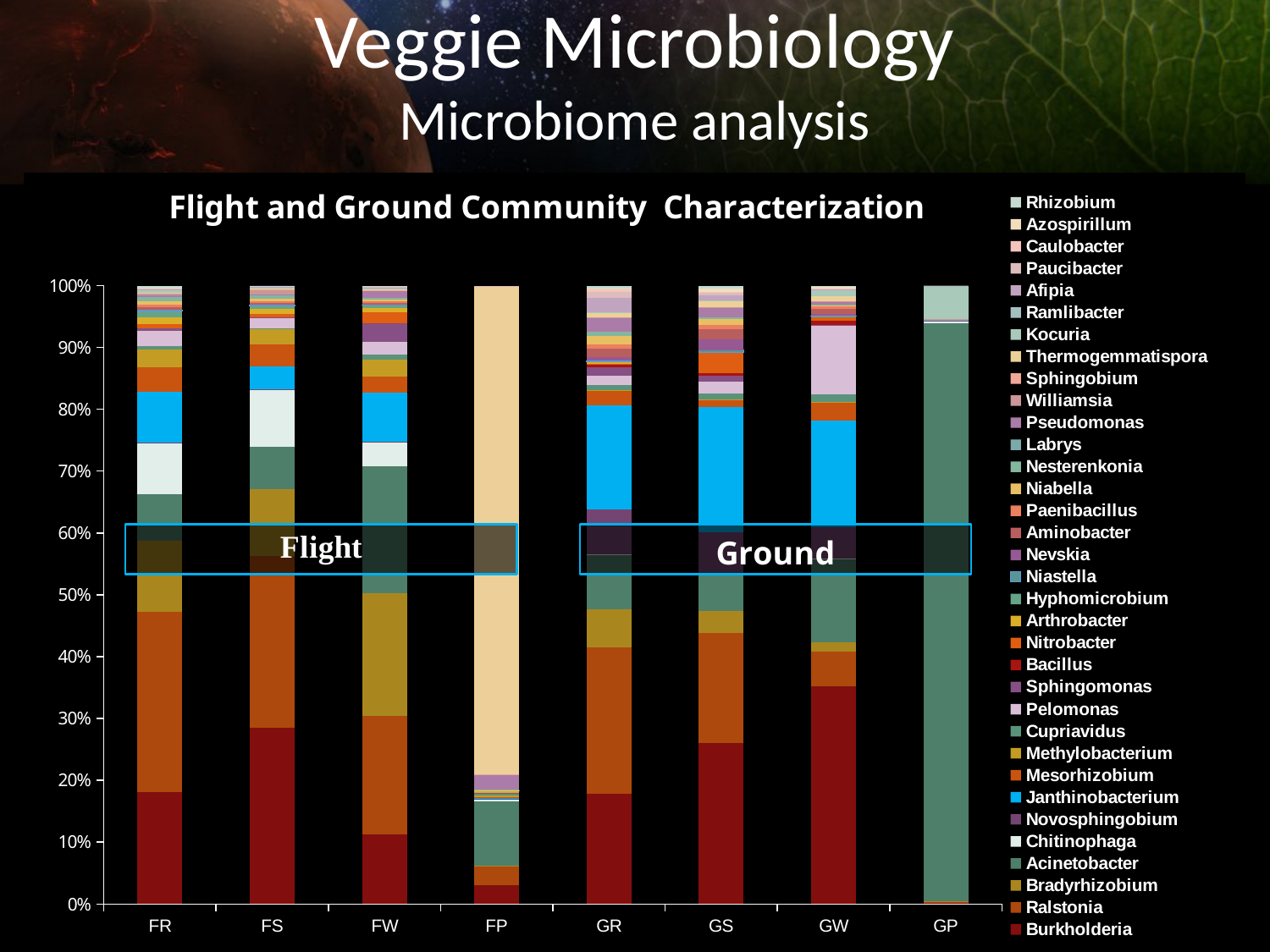
What is the title of the chart? Flight and Ground Community Characterization Which category has the smallest Burkholderia share? GP Is the Burkholderia share for GW greater or less than 30%? greater How many sample categories are shown along the x axis of the chart? 8 Is the Acinetobacter share for GP greater or less than 90%? greater Which has the larger Burkholderia share, FR or GW? GW What kind of chart is shown on the slide? Stacked bar chart Is the Burkholderia share for FP greater or less than 10%? less Which category is dominated by Thermogemmatispora? FP Which legend entry is listed at the bottom of the legend? Burkholderia How many series does the chart legend list? 34 Which category has the largest Burkholderia share? GW